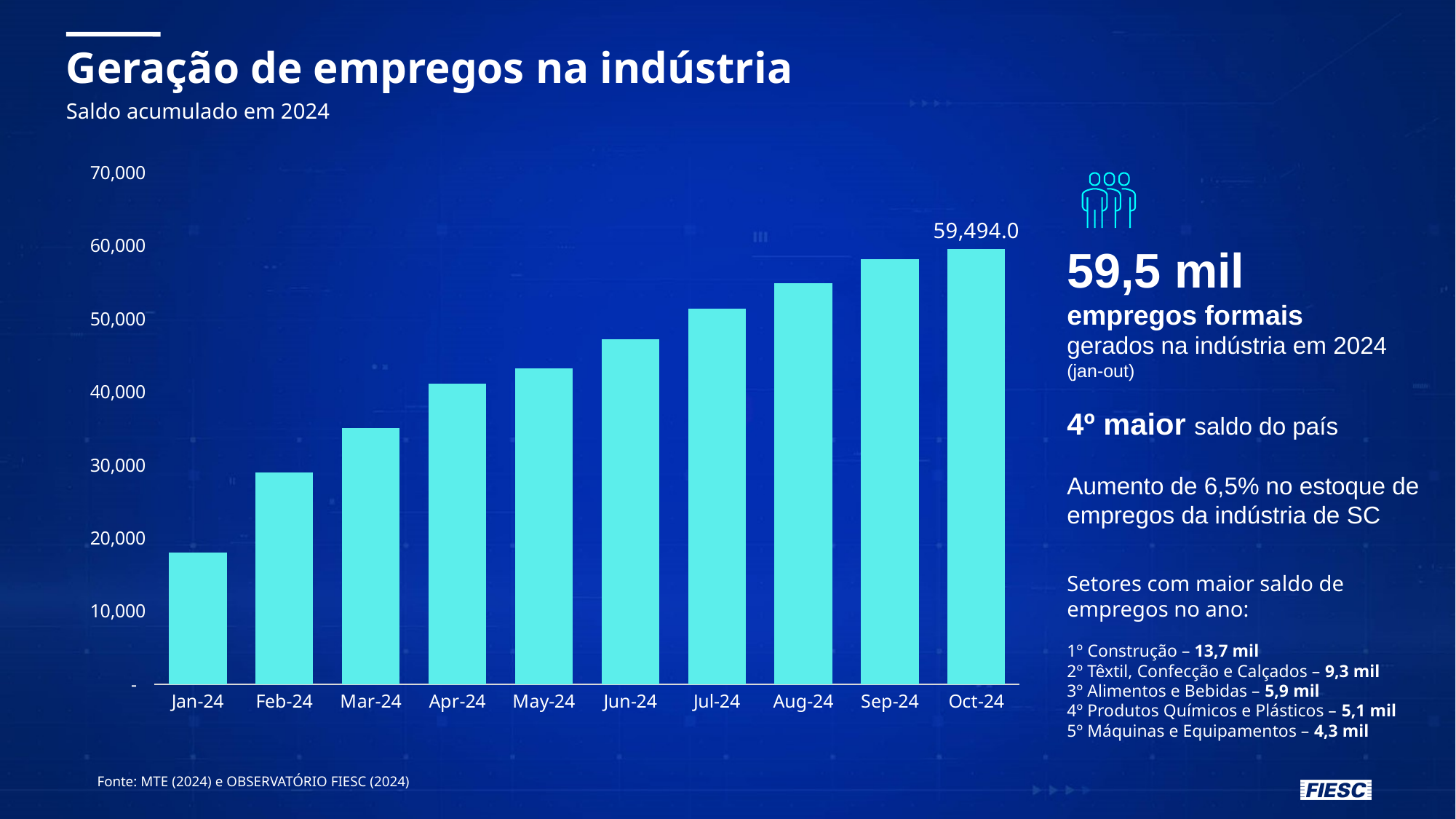
Is the value for Mar-24 greater or less than 30,000? greater Which month has the highest bar? Oct-24 Is the value for Sep-24 greater or less than 60,000? less Which is larger, the value for Aug-24 or the value for May-24? Aug-24 Which month has the lowest bar? Jan-24 Do the values rise or fall from Jan-24 to Oct-24? Rise Is the value for Jun-24 greater or less than 50,000? less What is the title of the chart on the slide? Geração de empregos na indústria What kind of chart is shown on the slide? Bar chart What is the value shown for Oct-24? 59,494.0 How many months are plotted on the chart? 10